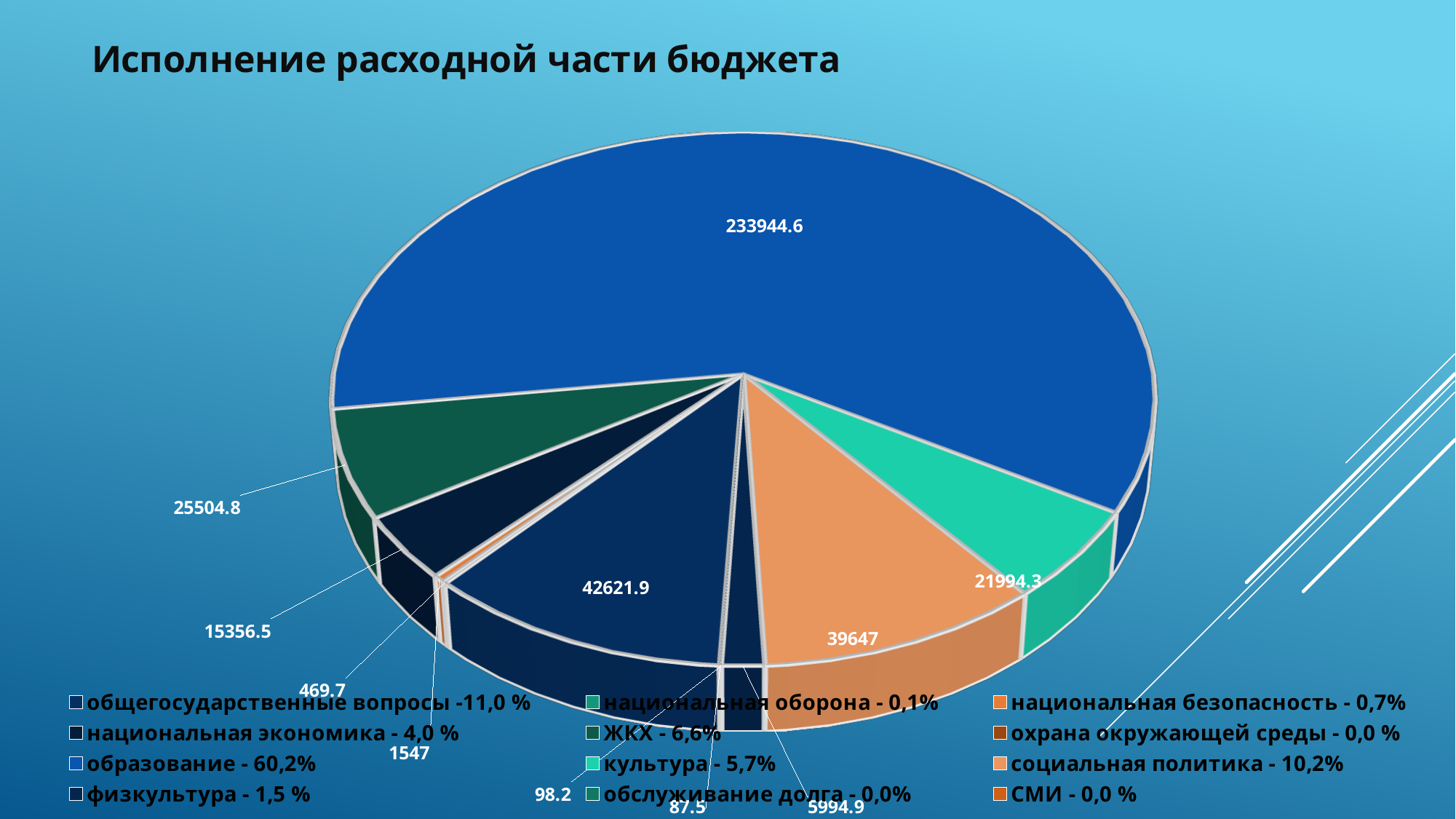
How many entries does the chart legend list? 12 What kind of chart is shown on the slide? pie chart What is the title of the chart? Исполнение расходной части бюджета What value is labelled on the общегосударственные вопросы slice? 42621.9 What share of the pie does образование account for, according to the legend? 60,2% What is the difference between the общегосударственные вопросы value (42621.9) and the социальная политика value (39647)? 2974.9 Which slice is larger: ЖКХ or культура? ЖКХ What share of the pie does ЖКХ account for, according to the legend? 6,6% What value is labelled on the образование slice? 233944.6 Which category has the largest slice of the pie? образование What value is labelled on the культура slice? 21994.3 What share of the pie does социальная политика account for, according to the legend? 10,2%